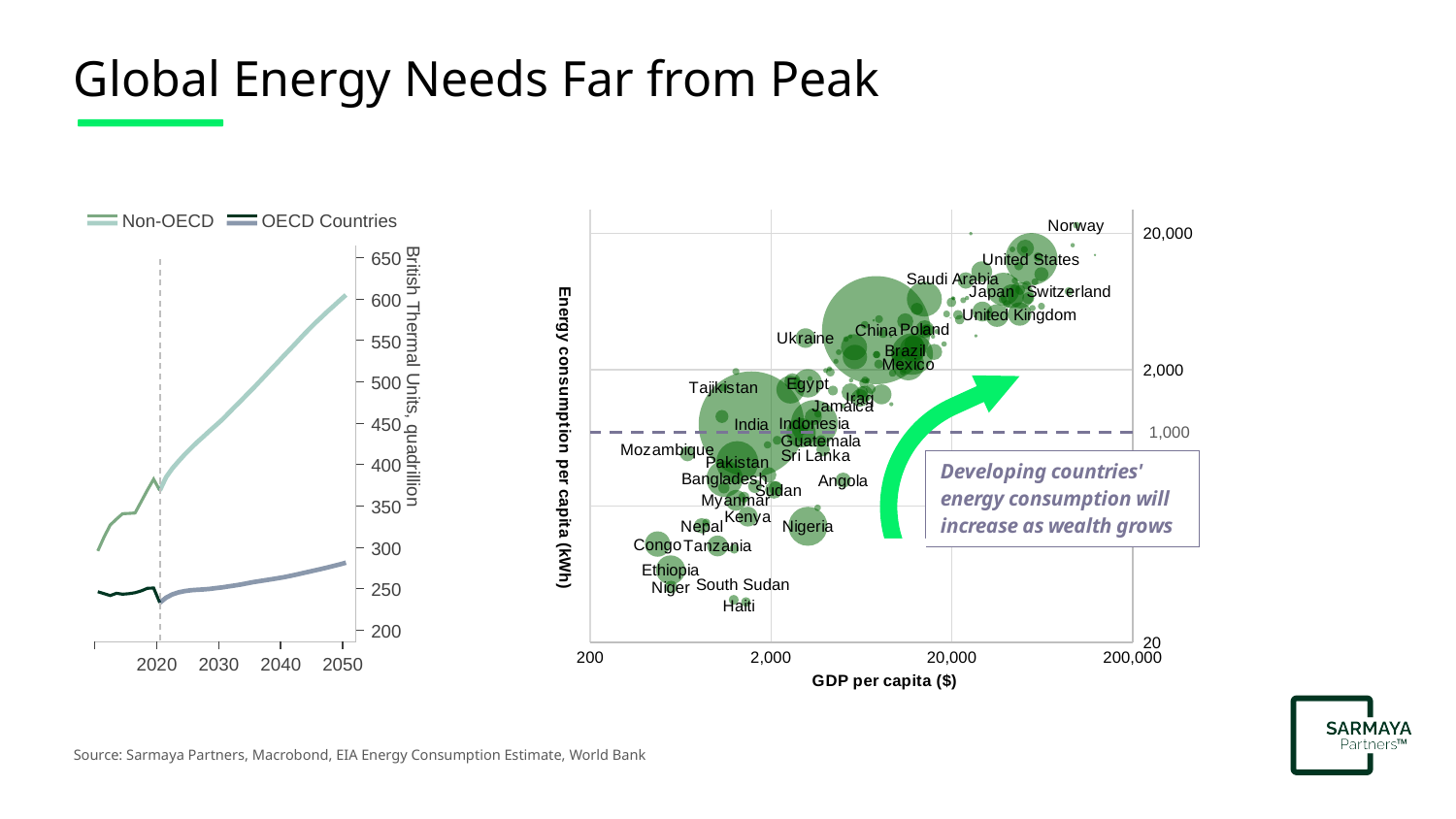
On the right chart, is Haiti's energy consumption per capita greater or less than 1,000 kWh? less On the left chart, what unit is shown on the vertical axis label? British Thermal Units, quadrillion On the left chart, does the Non-OECD line rise or fall from 2020 to 2050? Rise On the right chart, what is the label of the horizontal axis? GDP per capita ($) On the right chart, is Norway's energy consumption per capita greater or less than 2,000 kWh? greater On the left chart, which series is higher in 2050, Non-OECD or OECD Countries? Non-OECD On the right chart, is Nigeria's GDP per capita greater or less than 20,000? less On the right chart, which country has the higher GDP per capita, United States or India? United States What kind of chart is the left chart showing Non-OECD and OECD Countries? Line chart On the left chart, how many series does the legend list? 2